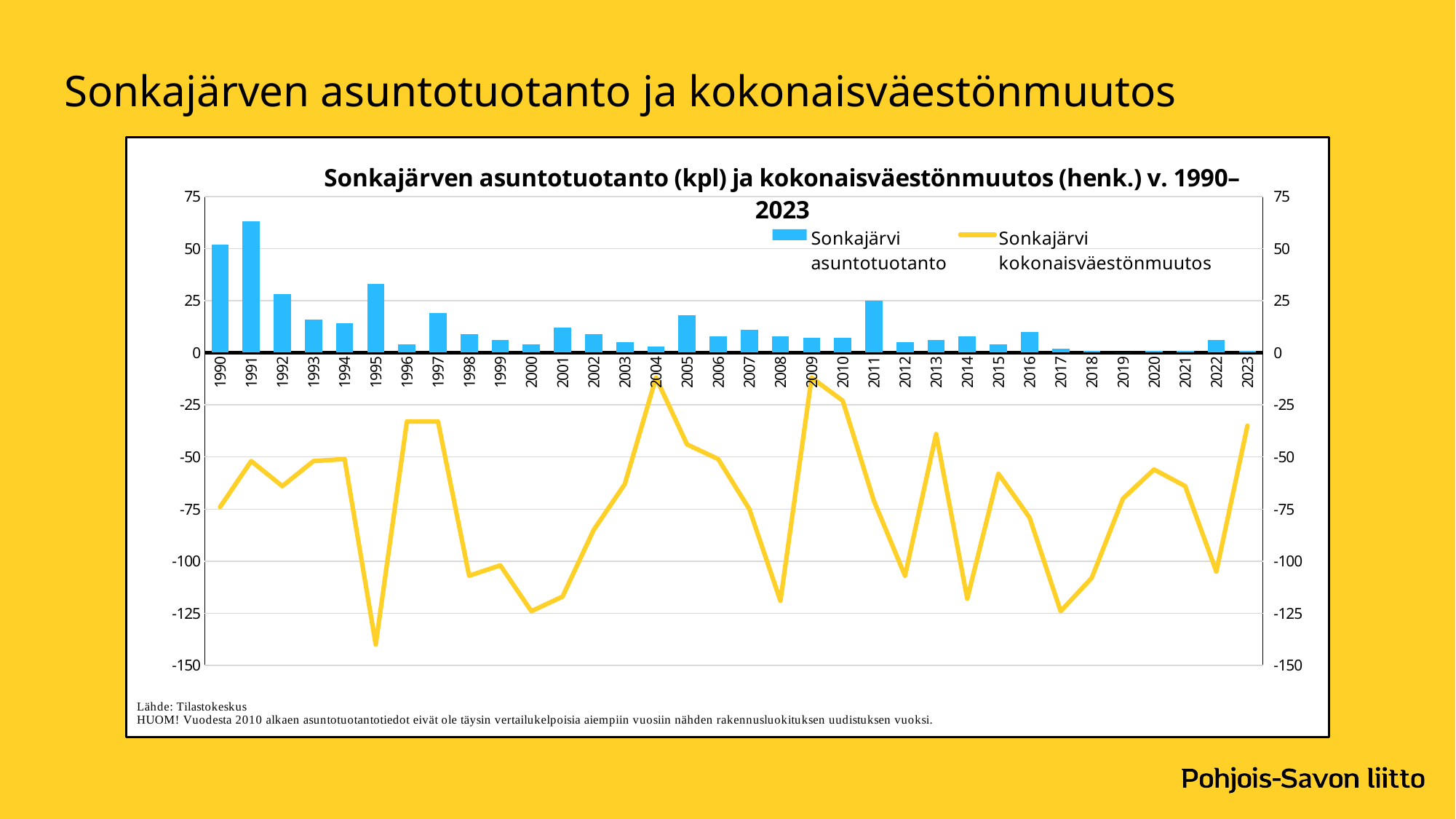
How many series does the legend list? 2 How many years are plotted along the x axis? 34 Which year has the lowest value for Sonkajärvi kokonaisväestönmuutos? 1995 What kind of chart is shown on the slide? A combined bar and line chart Is the value for Sonkajärvi kokonaisväestönmuutos in 1995 greater or less than -125? less Is the value for Sonkajärvi asuntotuotanto in 1997 greater or less than 25? less Which year has the highest value for Sonkajärvi asuntotuotanto? 1991 Is the value for Sonkajärvi asuntotuotanto in 1991 greater or less than 50? greater Overall, do the Sonkajärvi asuntotuotanto bars rise or fall from 1990 to 2023? fall Which is larger, the Sonkajärvi asuntotuotanto value for 1995 or for 2011? 1995